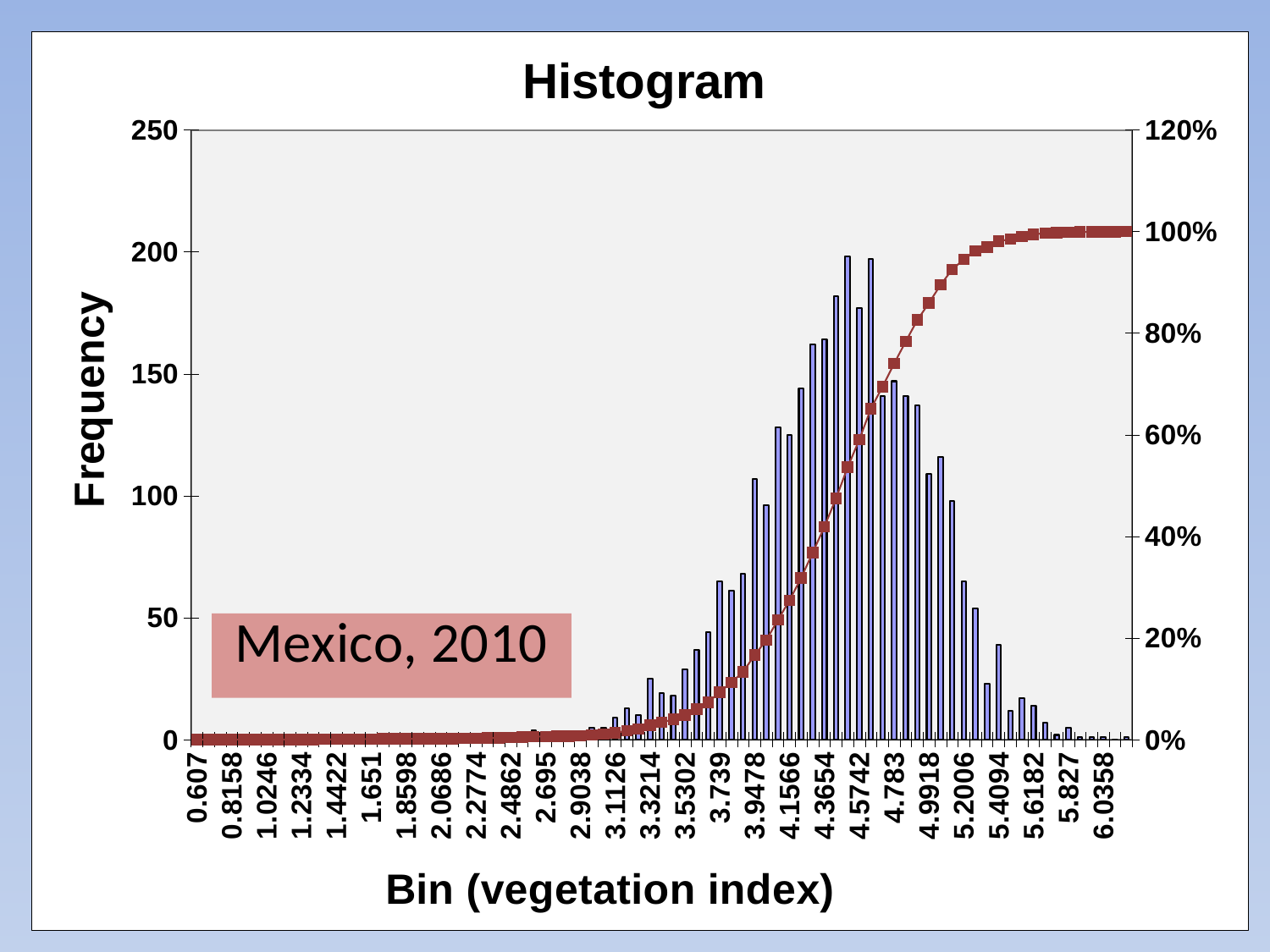
Is the frequency for bin 0.607 greater or less than 50? less What kind of chart is shown on the slide? bar chart with a cumulative line Is the cumulative percentage at bin 2.695 greater or less than 20%? less Is the cumulative percentage at bin 6.0358 greater or less than 80%? greater Does the cumulative percentage line rise or fall as the bin value increases along the x axis? rise What is the title of the chart? Histogram What is the highest value shown on the left (Frequency) axis? 250 What is the label of the x axis? Bin (vegetation index)